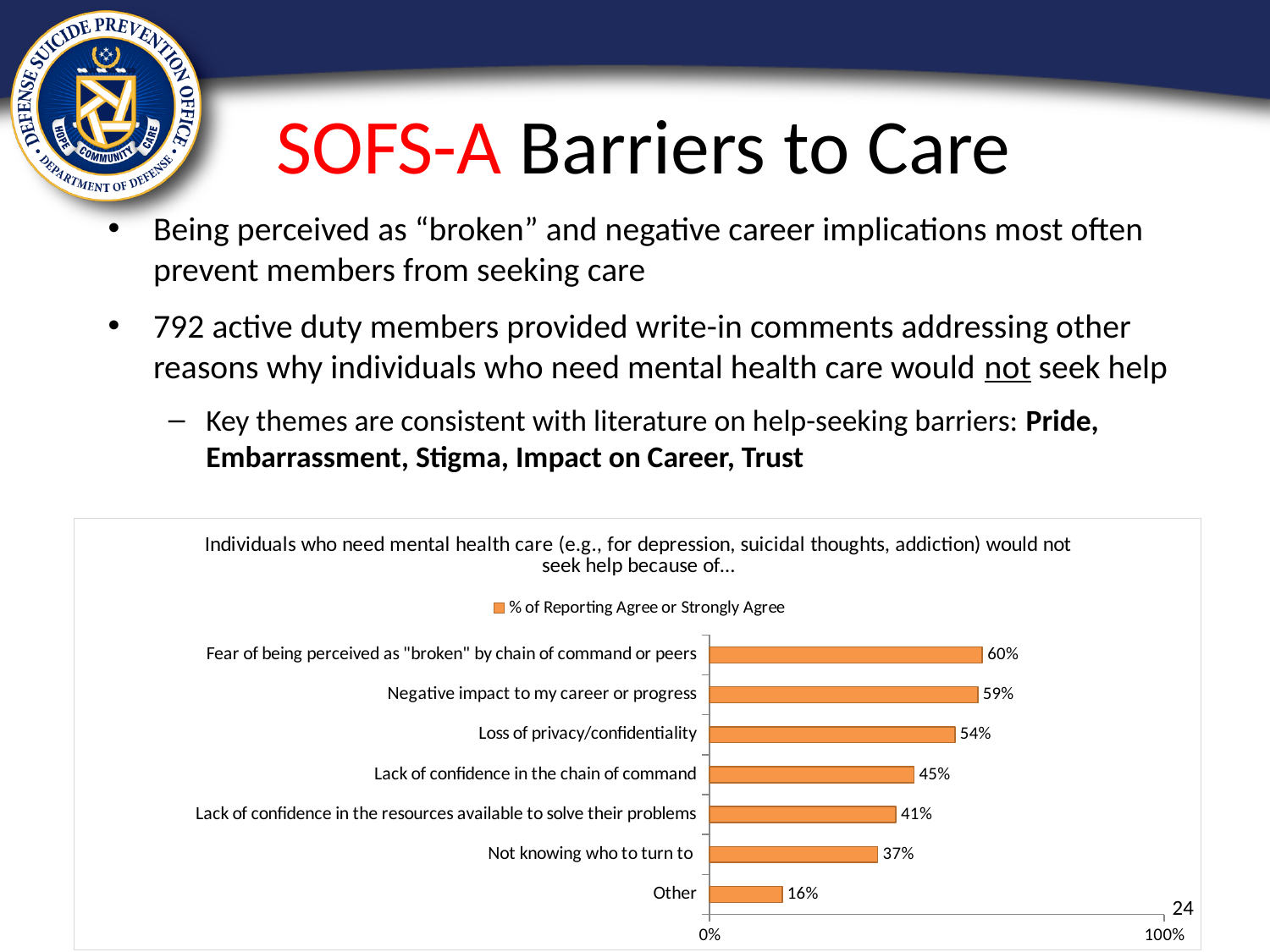
What is the difference between the values for "Fear of being perceived as "broken" by chain of command or peers" and "Other"? 44% What is the value shown for "Lack of confidence in the resources available to solve their problems"? 41% How many series does the legend list? 1 What kind of chart is shown on the slide? Bar chart What is the value shown for "Not knowing who to turn to"? 37% What percentage of respondents agreed or strongly agreed that "Loss of privacy/confidentiality" is a reason individuals would not seek help? 54% Which category has the lowest percentage in the chart? Other What is the difference between the values for "Negative impact to my career or progress" and "Lack of confidence in the chain of command"? 14% What is the legend entry for the series in the chart? % of Reporting Agree or Strongly Agree Which is larger: the value for "Loss of privacy/confidentiality" or the value for "Not knowing who to turn to"? Loss of privacy/confidentiality Which category has the highest percentage in the chart? Fear of being perceived as "broken" by chain of command or peers How many categories are shown in the chart? 7